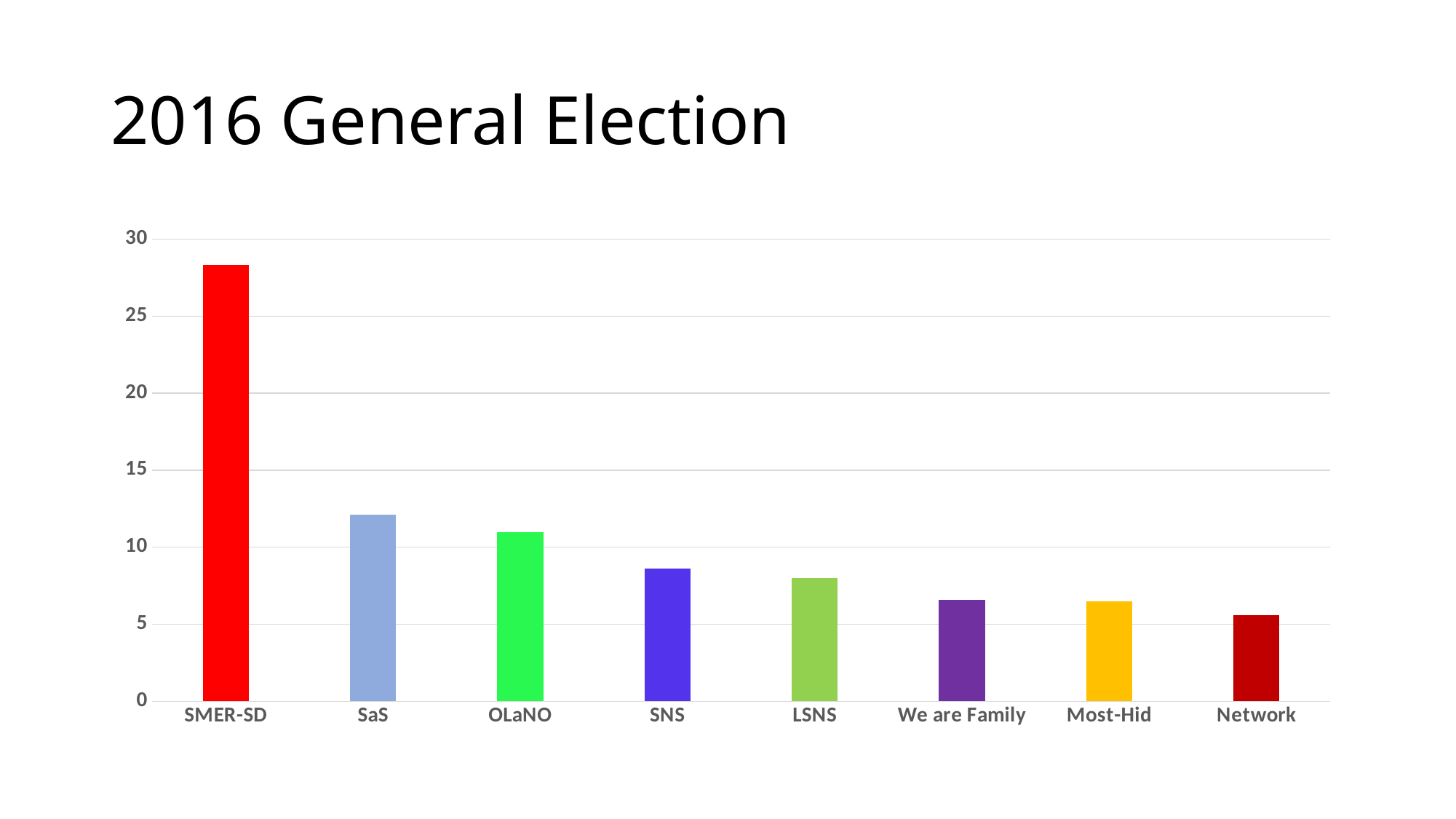
What type of chart is shown on the slide? bar chart Which party has the highest bar in the chart? SMER-SD What is the title of the slide containing the chart? 2016 General Election Which is larger, the value for SaS or the value for LSNS? SaS Is the value for OLaNO greater or less than 15? less Is the value for SMER-SD greater or less than 25? greater Do the bar values rise or fall from left to right along the x axis? fall Is the value for SaS greater or less than 10? greater Which party has the lowest bar in the chart? Network How many parties are shown on the x axis? 8